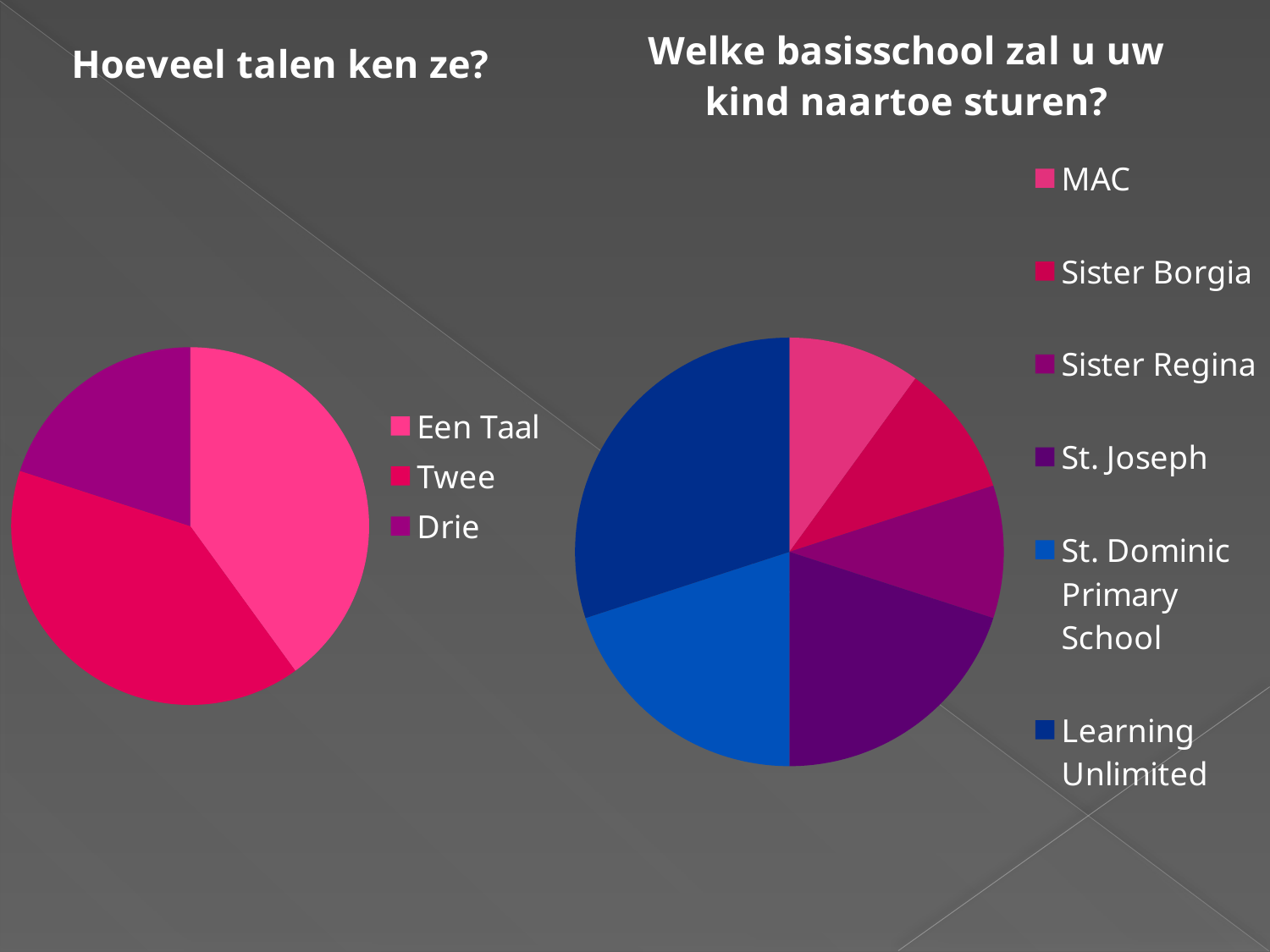
In the chart titled "Welke basisschool zal u uw kind naartoe sturen?", which school has the largest slice? Learning Unlimited In the chart titled "Welke basisschool zal u uw kind naartoe sturen?", how many categories does the legend list? 6 What kind of chart is the chart titled "Welke basisschool zal u uw kind naartoe sturen?"? pie chart What kind of chart is the chart titled "Hoeveel talen ken ze?"? pie chart What is the title of the pie chart on the right side of the slide? Welke basisschool zal u uw kind naartoe sturen? In the chart titled "Hoeveel talen ken ze?", how many slices does the pie have? 3 In the chart titled "Welke basisschool zal u uw kind naartoe sturen?", which slice is larger, St. Joseph or Sister Regina? St. Joseph In the chart titled "Hoeveel talen ken ze?", what are the three legend entries? Een Taal, Twee, Drie In the chart titled "Welke basisschool zal u uw kind naartoe sturen?", which slice is larger, Learning Unlimited or MAC? Learning Unlimited In the chart titled "Hoeveel talen ken ze?", which category has the smallest slice? Drie In the chart titled "Hoeveel talen ken ze?", which slice is larger, Twee or Drie? Twee